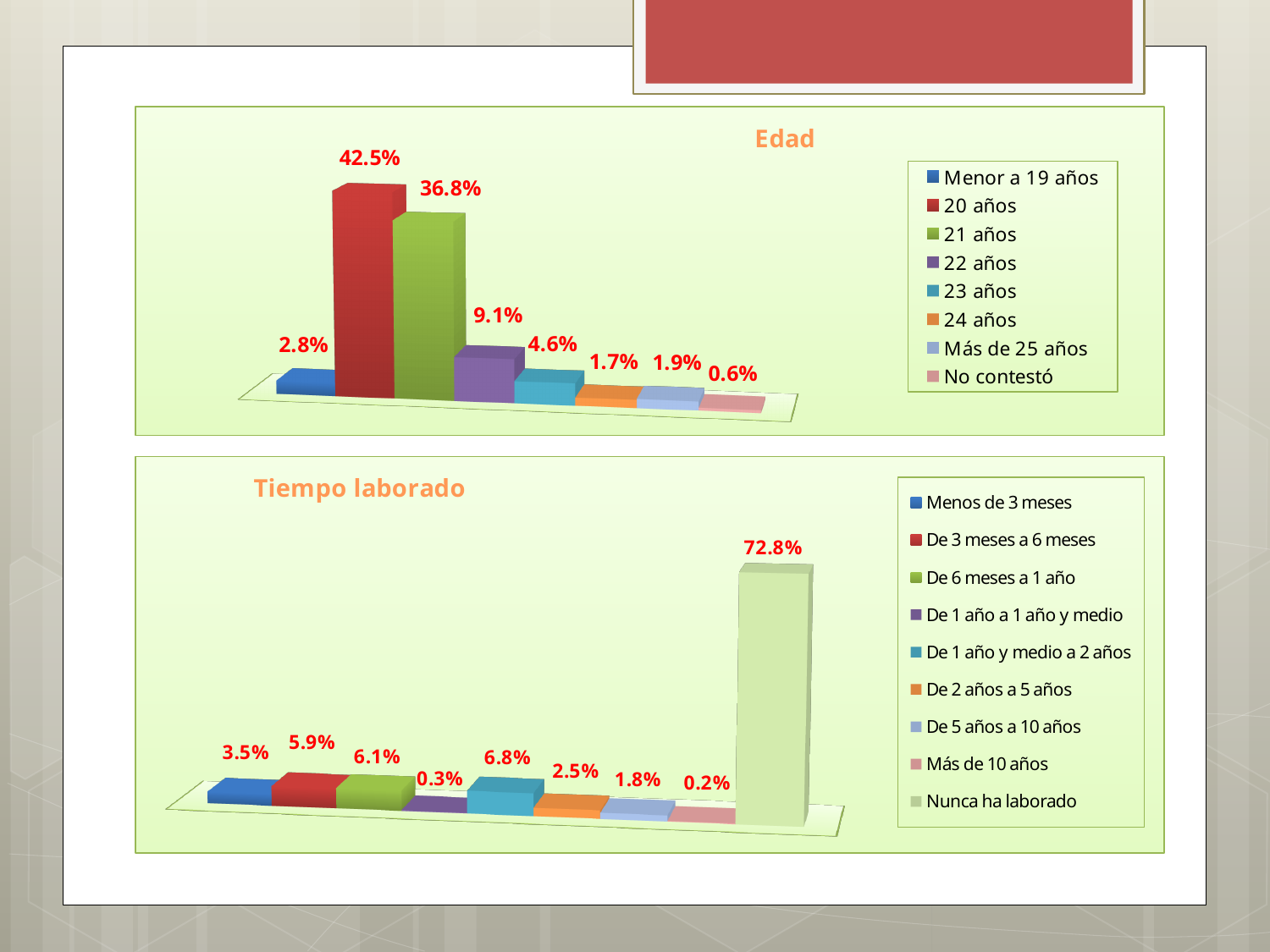
In the 'Edad' chart, what is the value for 20 años? 42.5% In the 'Edad' chart, how many categories does the legend list? 8 In the 'Tiempo laborado' chart, what is the value for Nunca ha laborado? 72.8% In the 'Edad' chart, which category has the lowest value? No contestó In the 'Tiempo laborado' chart, how many categories does the legend list? 9 In the 'Tiempo laborado' chart, what is the difference between the values for De 6 meses a 1 año and Menos de 3 meses? 2.6% In the 'Tiempo laborado' chart, which category has the lowest value? Más de 10 años What type of chart is the 'Tiempo laborado' chart? Bar chart In the 'Edad' chart, what is the value for 22 años? 9.1% In the 'Edad' chart, which is larger, the value for 23 años or the value for 24 años? 23 años In the 'Tiempo laborado' chart, what is the value for De 1 año y medio a 2 años? 6.8% In the 'Edad' chart, what is the difference between the values for 20 años and 21 años? 5.7%